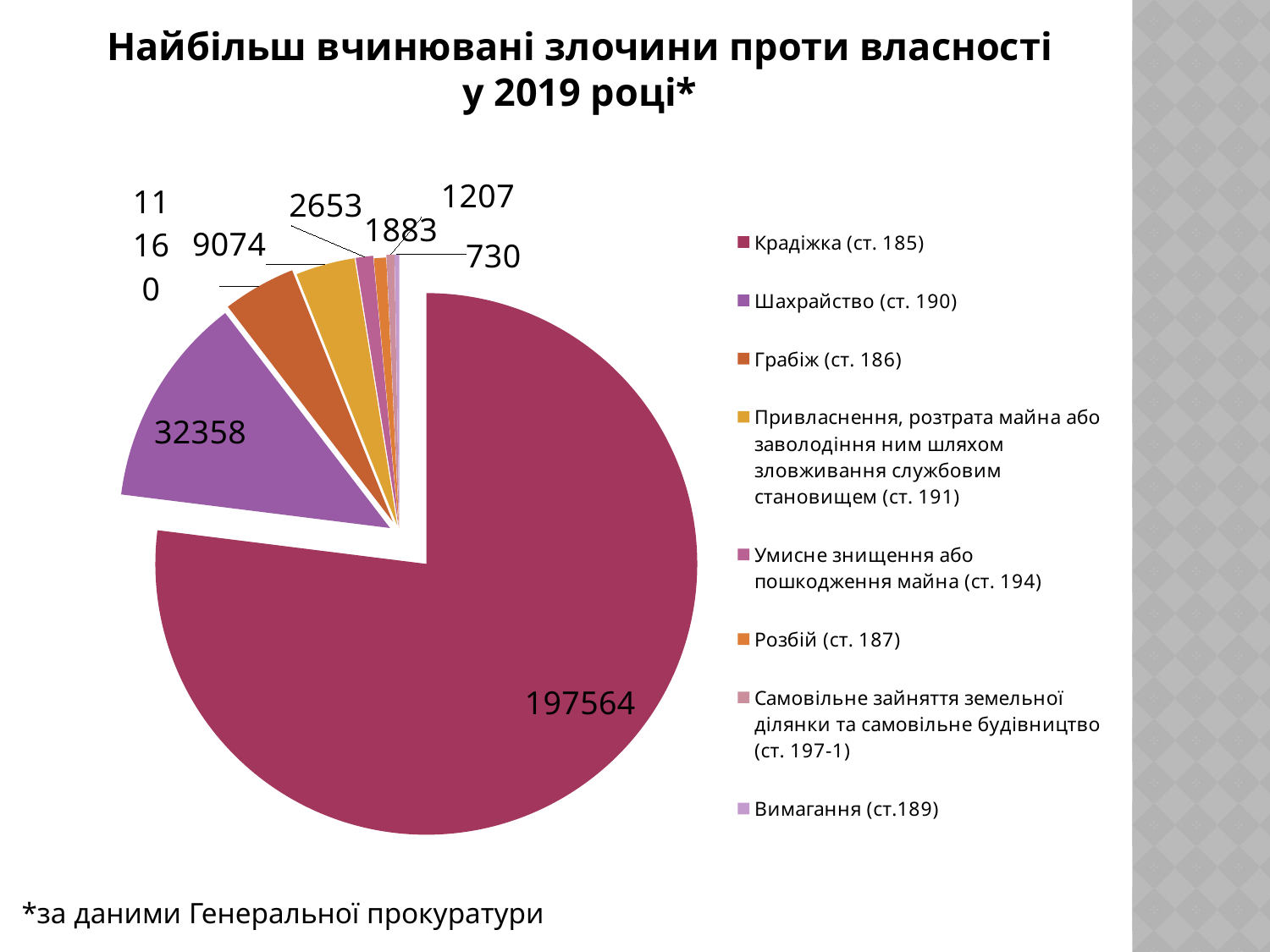
What kind of chart is shown on the slide? pie chart What is the value for Привласнення, розтрата майна або заволодіння ним шляхом зловживання службовим становищем (ст. 191)? 9074 What is the value for Вимагання (ст.189)? 730 Which category has the smallest slice of the pie? Вимагання (ст.189) What is the difference between the values for Крадіжка (ст. 185) and Шахрайство (ст. 190)? 165206 What is the value for Крадіжка (ст. 185)? 197564 Which category has the largest slice of the pie? Крадіжка (ст. 185) Which is larger: Шахрайство (ст. 190) or Грабіж (ст. 186)? Шахрайство (ст. 190) How many categories (slices) does the pie chart have? 8 What is the value for Розбій (ст. 187)? 1883 What is the value for Шахрайство (ст. 190)? 32358 What is the title of the chart? Найбільш вчинювані злочини проти власності у 2019 році*